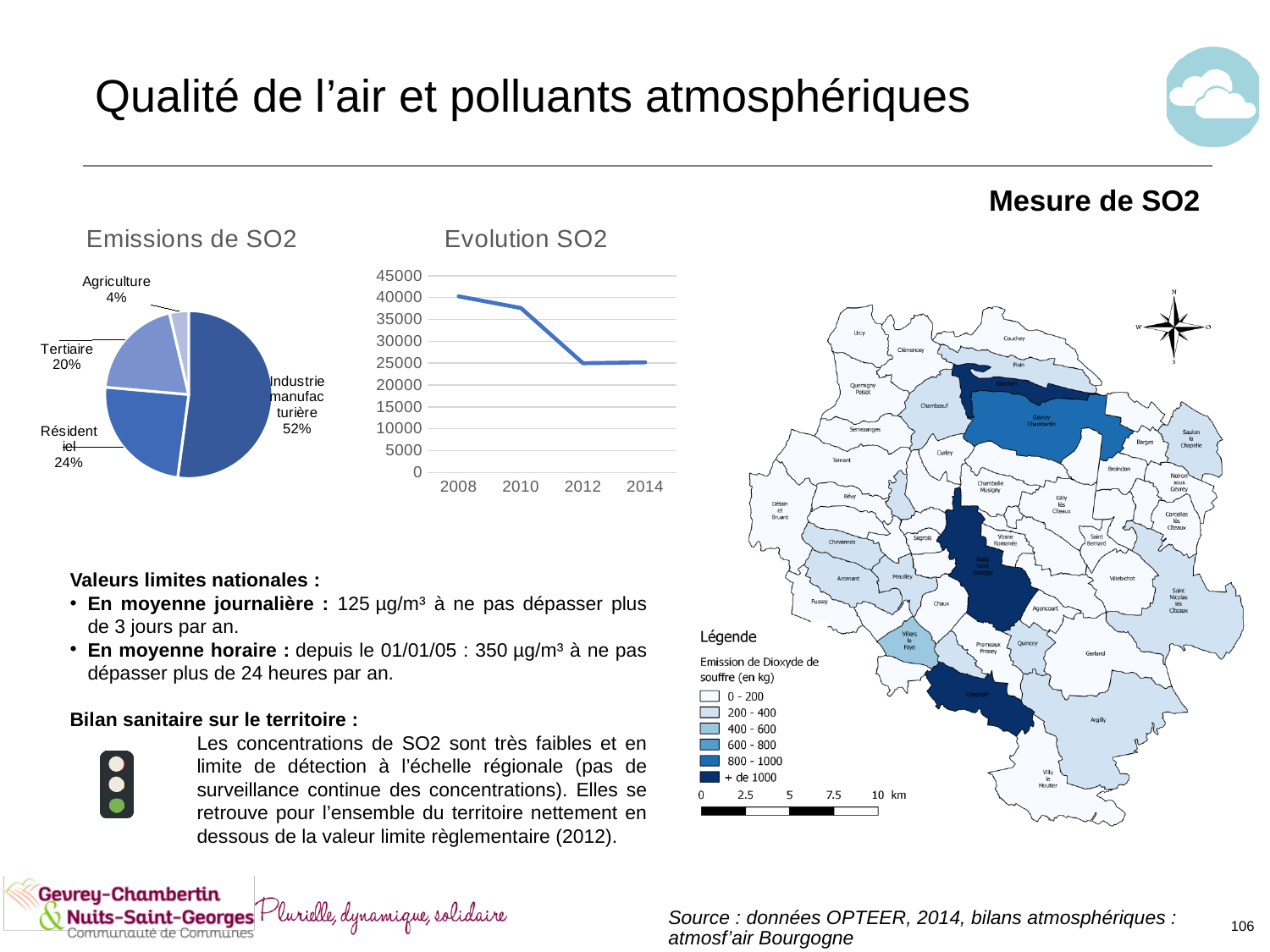
In the 'Emissions de SO2' chart, what is the difference in percentage points between the Résidentiel and Tertiaire shares? 4 In the 'Emissions de SO2' chart, which sector has the smallest share of emissions? Agriculture In the 'Evolution SO2' chart, do the values rise or fall from 2008 to 2014? Fall In the 'Evolution SO2' chart, is the value for 2012 greater or less than 30000? less In the 'Evolution SO2' chart, is the value for 2008 greater or less than 35000? greater In the 'Emissions de SO2' chart, what share of SO2 emissions comes from Tertiaire? 20% In the 'Emissions de SO2' chart, what share of SO2 emissions comes from Résidentiel? 24% In the 'Emissions de SO2' chart, what share of SO2 emissions comes from Industrie manufacturière? 52% In the 'Emissions de SO2' chart, how many sectors are shown? 4 In the 'Emissions de SO2' chart, which sector has the largest share of emissions? Industrie manufacturière What type of chart is 'Emissions de SO2'? Pie chart What type of chart is 'Evolution SO2'? Line chart